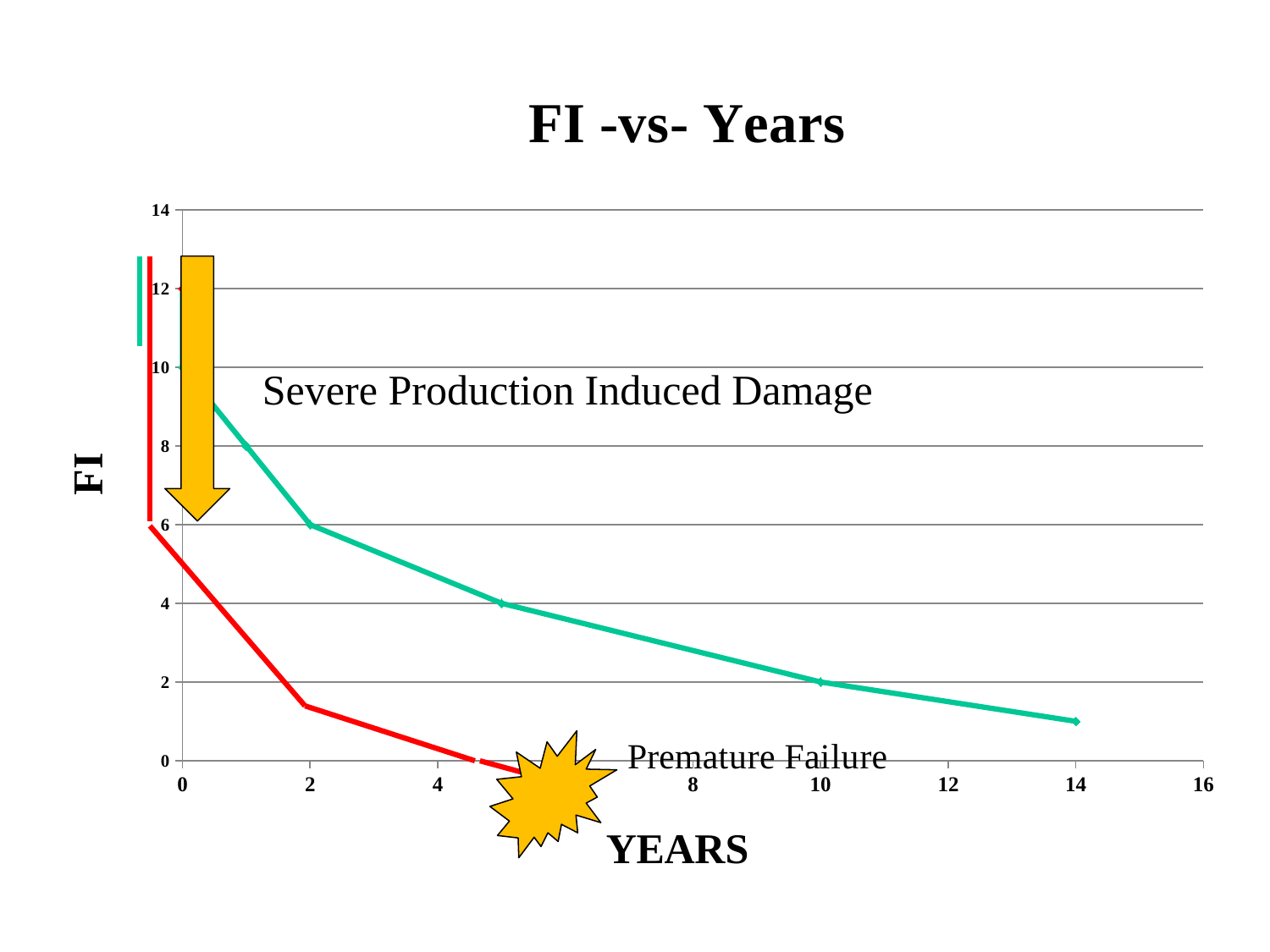
What is the highest tick value shown on the x axis? 16 Is the FI value of the red line at year 2 greater or less than 2? less Which line reaches an FI of 0 first, the red line or the green line? red line What is the label on the vertical axis of the chart? FI At year 2, which line has the higher FI value, the green line or the red line? green line How many lines are plotted on the chart? 2 What is the FI value of the green line at year 10? 2 Do the FI values rise or fall as the years increase along the x axis? fall What is the FI value of the green line at year 2? 6 What is the title of the chart? FI -vs- Years What kind of chart is shown on the slide? line chart Is the FI value of the green line at year 14 greater or less than 2? less